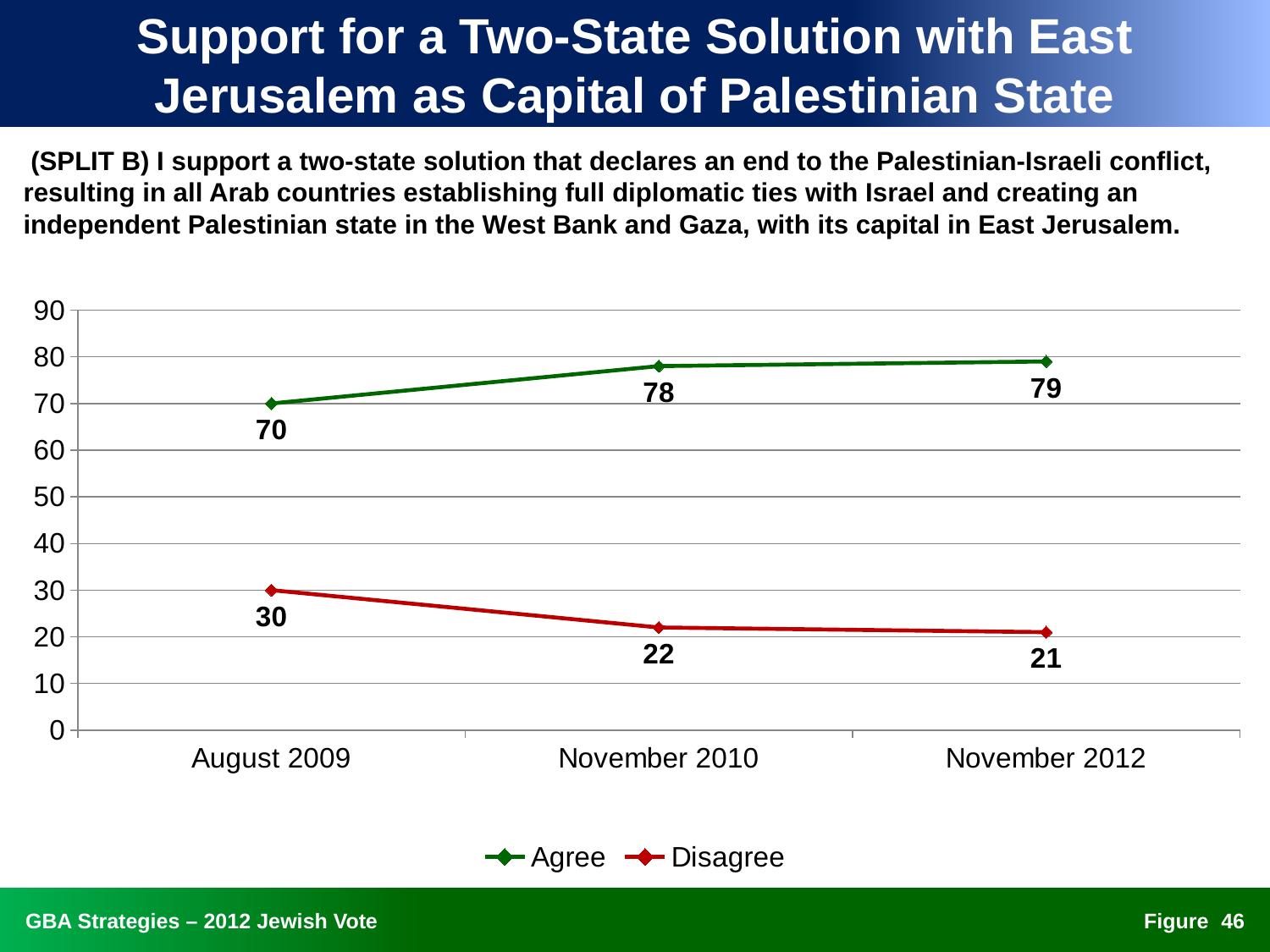
What is the Agree value for November 2010? 78 How many series does the legend list? 2 In which period is the Disagree value lowest? November 2012 What is the Agree value for August 2009? 70 By how much did the Agree value change from August 2009 to November 2012? 9 What is the Disagree value for November 2012? 21 In which period is the Agree value highest? November 2012 Which is larger in August 2009, Agree or Disagree? Agree How many time periods are shown on the x axis? 3 What kind of chart is shown on the slide? Line chart Does the Disagree series rise or fall from August 2009 to November 2012? Fall What is the difference between the Agree and Disagree values in November 2010? 56